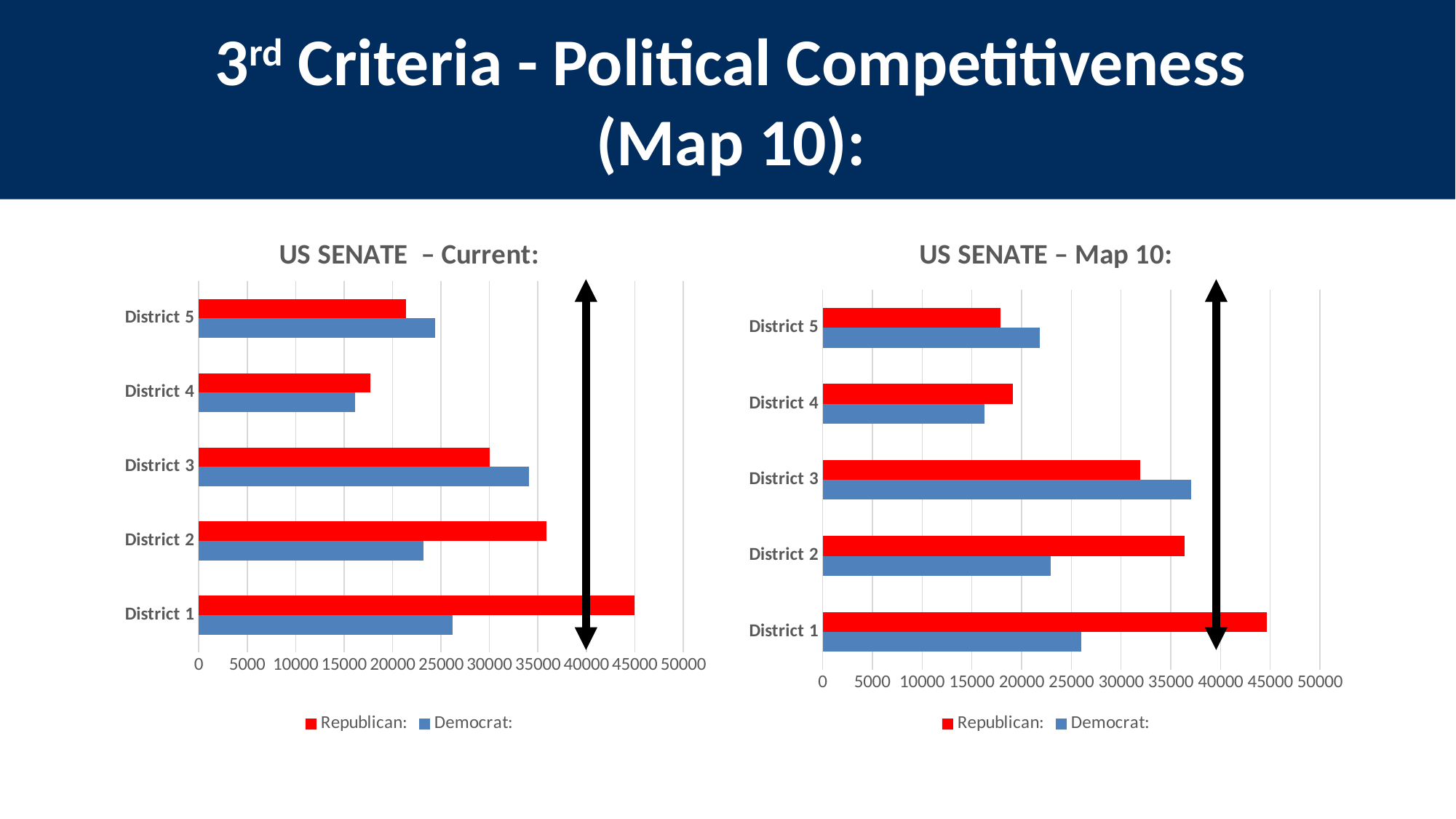
In the 'US SENATE – Current:' chart, is the Republican value for District 1 greater or less than 40000? greater In the 'US SENATE – Current:' chart, which district has the highest Republican value? District 1 In the 'US SENATE – Current:' chart, how many districts are shown? 5 In the 'US SENATE – Map 10:' chart, which district has the highest Democrat value? District 3 In the 'US SENATE – Map 10:' chart, which district has the lowest Democrat value? District 4 In the 'US SENATE – Map 10:' chart, is the Democrat value for District 4 greater or less than 20000? less In the 'US SENATE – Current:' chart, which district has the lowest Republican value? District 4 In the 'US SENATE – Current:' chart, for District 3, which is larger: Republican or Democrat? Democrat In the 'US SENATE – Current:' chart, what are the two legend entries? Republican and Democrat In the 'US SENATE – Current:' chart, what kind of chart is used? bar chart In the 'US SENATE – Map 10:' chart, how many series does the legend list? 2 In the 'US SENATE – Map 10:' chart, for District 2, which is larger: Republican or Democrat? Republican